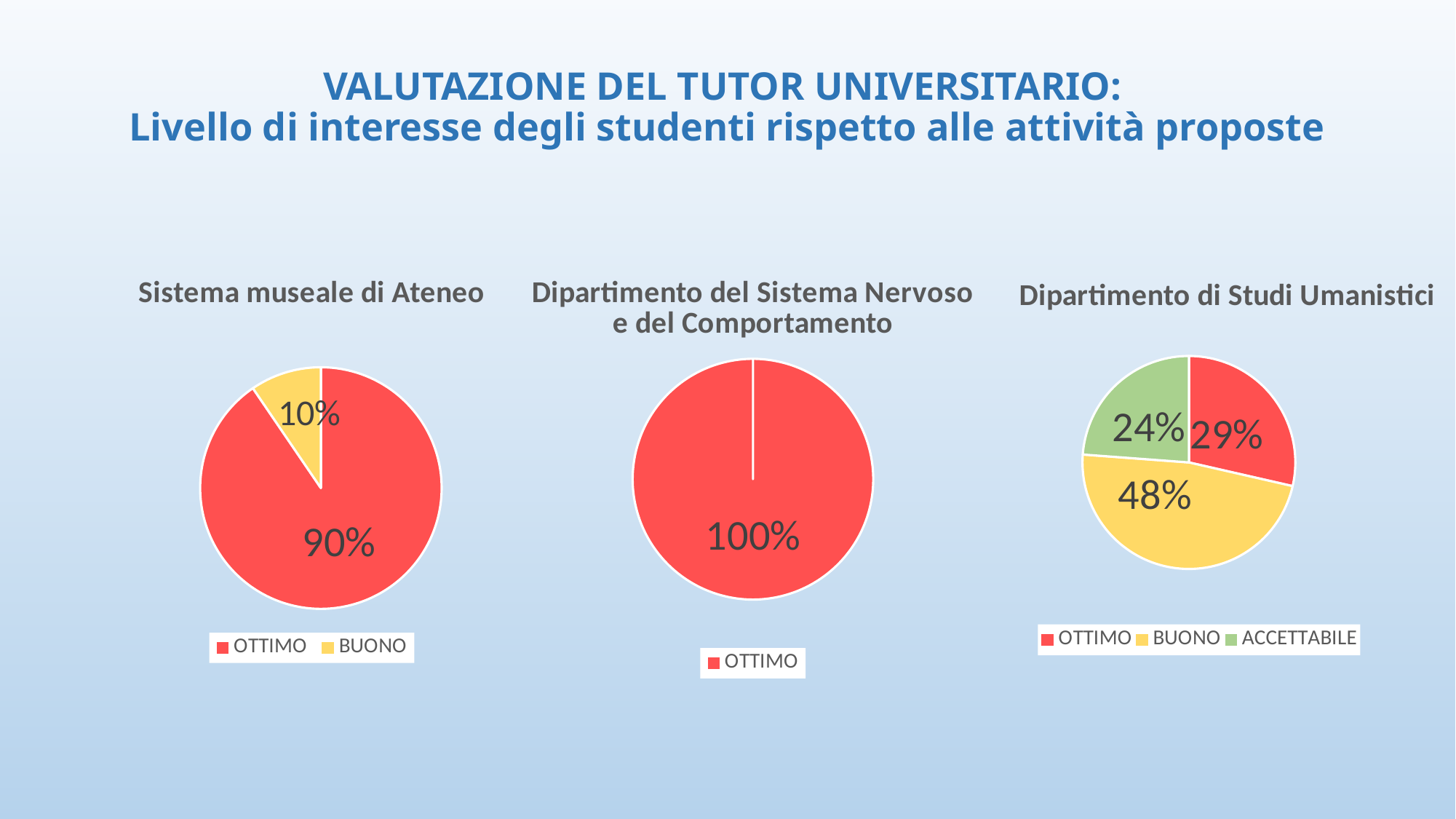
In the 'Sistema museale di Ateneo' chart, what share of the pie is BUONO? 10% In the 'Dipartimento di Studi Umanistici' chart, what share of the pie is ACCETTABILE? 24% In the 'Dipartimento di Studi Umanistici' chart, which category has the largest slice? BUONO In the 'Sistema museale di Ateneo' chart, which is larger, OTTIMO or BUONO? OTTIMO How many pie charts are shown on the slide? 3 In the 'Dipartimento di Studi Umanistici' chart, which category has the smallest slice? ACCETTABILE In the 'Dipartimento del Sistema Nervoso e del Comportamento' chart, what share of the pie is OTTIMO? 100% What kind of chart is the 'Sistema museale di Ateneo' chart? Pie chart In the 'Dipartimento di Studi Umanistici' chart, what is the difference between the BUONO and OTTIMO shares? 19% How many categories does the legend of the 'Dipartimento di Studi Umanistici' chart list? 3